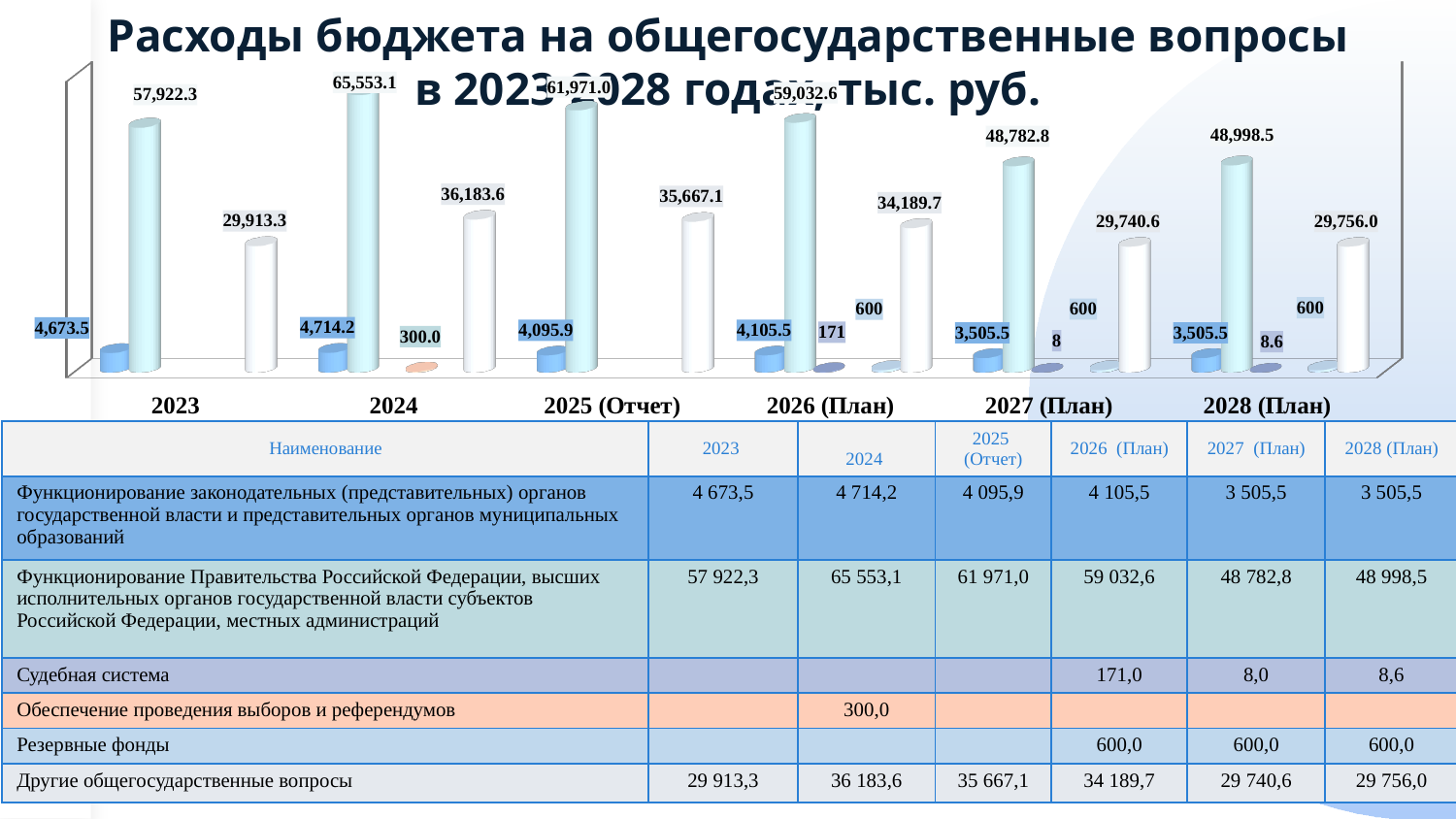
Which year has the lowest value for the tallest series (Функционирование Правительства Российской Федерации...)? 2027 (План) What is the value labelled 300.0 in the chart, and in which year does it appear? 2024 How many year categories are shown along the x axis of the chart? 6 What is the value of the smallest labelled bar for 2023? 4,673.5 In which year is the tallest bar of the whole chart found? 2024 What kind of chart is shown on the slide? bar chart Which is larger: the 'Другие общегосударственные вопросы' bar for 2024 or for 2025 (Отчет)? 2024 Does the value for the tallest series rise or fall from 2026 (План) to 2027 (План)? fall What is the data label on the tallest bar for 2024? 65,553.1 What is the difference between the tallest bar in 2024 (65,553.1) and the tallest bar in 2023 (57,922.3)? 7,630.8 What is the title of the chart? Расходы бюджета на общегосударственные вопросы в 2023-2028 годах, тыс. руб. What is the data label on the tallest bar for 2027 (План)? 48,782.8